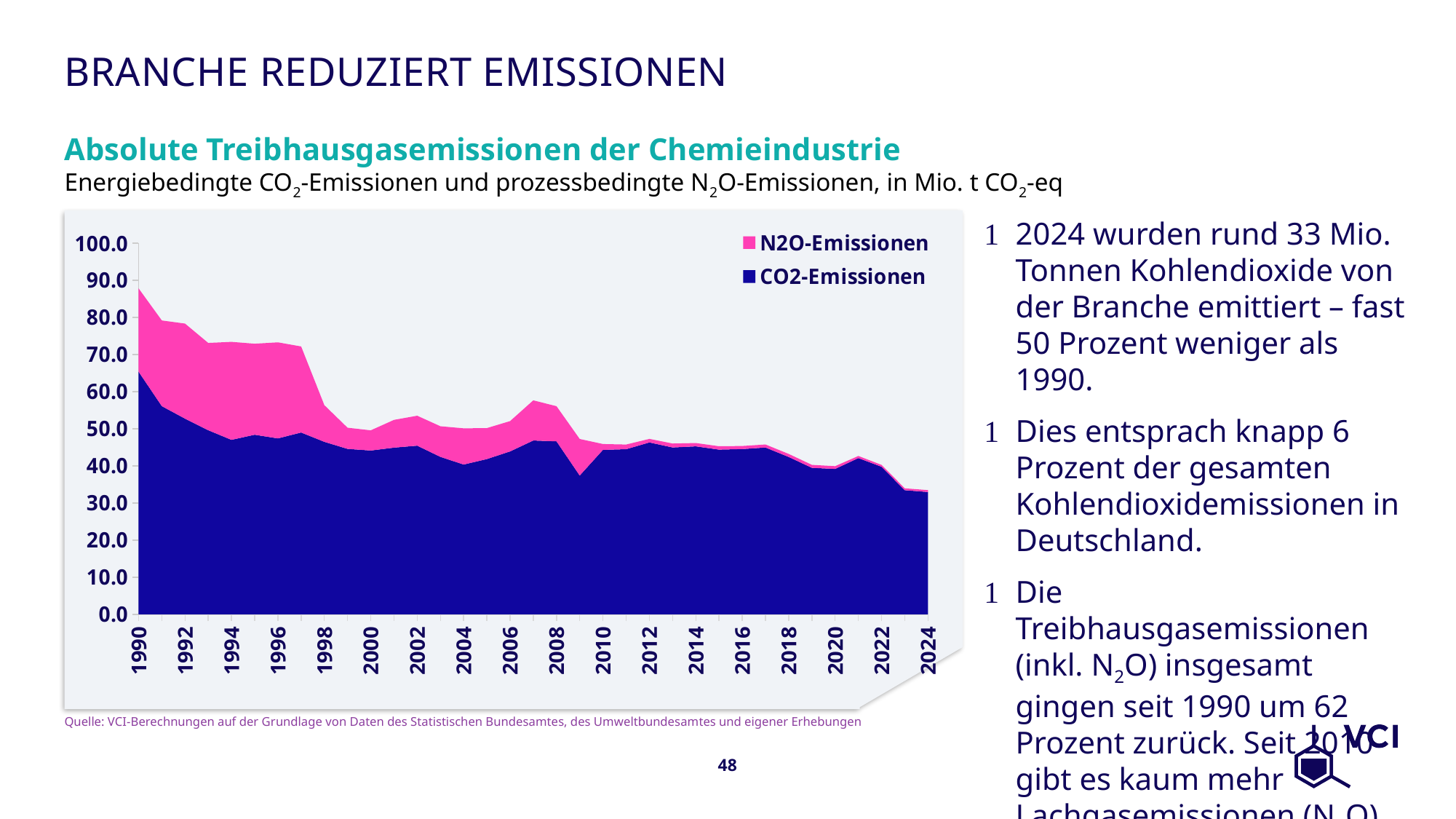
Are the CO2-Emissionen in 2009 greater or less than 40.0? less What kind of chart is shown on the slide? Stacked area chart Are the CO2-Emissionen in 1990 greater or less than 60.0? greater Which two series are listed in the chart legend? N2O-Emissionen and CO2-Emissionen Which colour represents the N2O-Emissionen series in the chart? Pink Are the total emissions in 1990 greater or less than 80.0? greater In which year are the total emissions (CO2 plus N2O) highest? 1990 How many series does the chart legend list? 2 Do the total emissions in the chart rise or fall from 1990 to 2024? Fall Which year has larger total emissions, 1990 or 2024? 1990